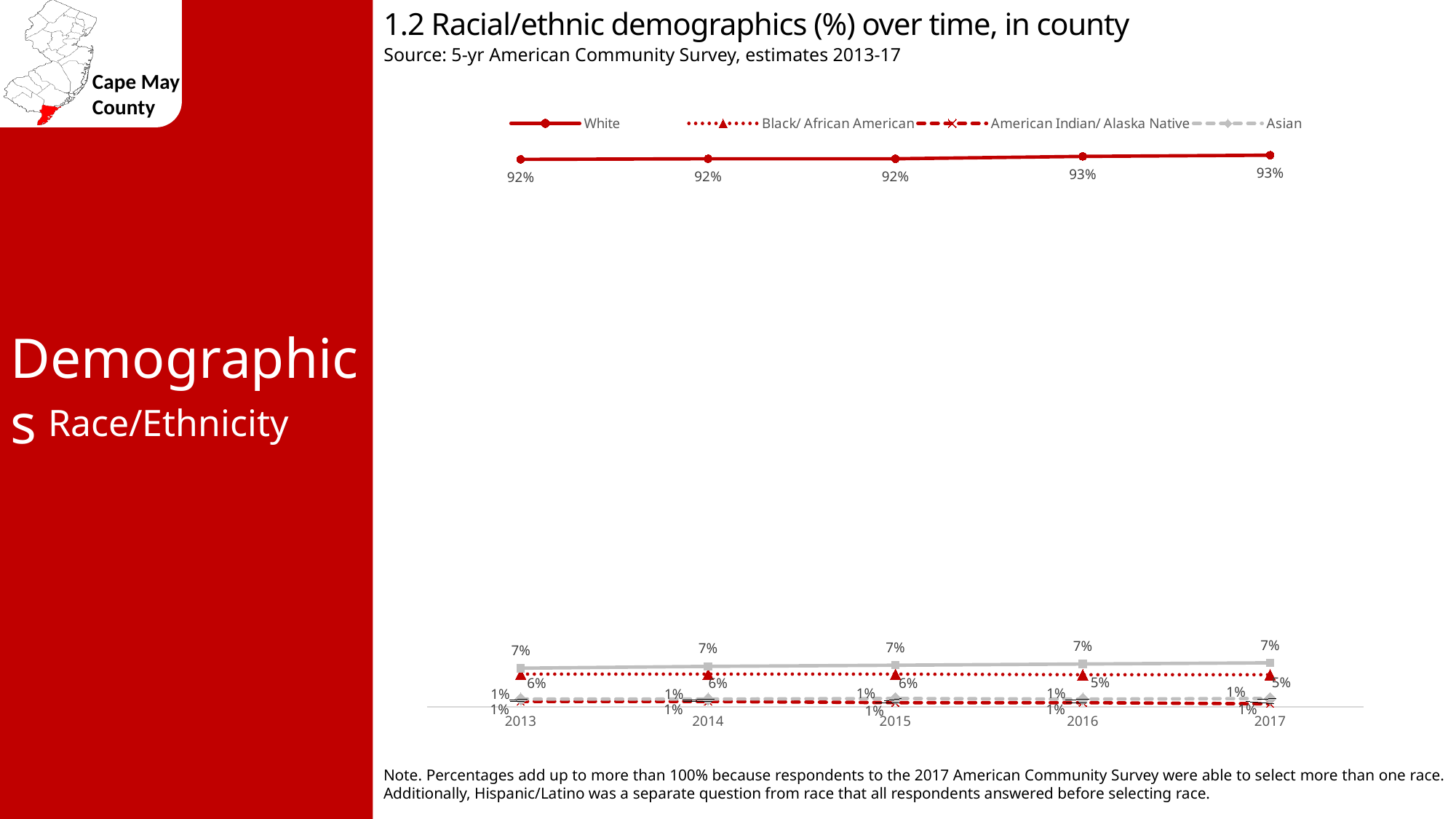
Which series has the highest values across all years? White What kind of chart is shown on the slide? Line chart What is the difference between the White value in 2017 and the White value in 2013? 1% How many years are shown on the x axis? 5 How many series does the legend list? 4 What is the value for Black/ African American in 2017? 5% What is the value for White in 2016? 93% What is the value for Black/ African American in 2013? 6% Which is larger in 2015: the value for White or the value for Black/ African American? White What is the value for White in 2013? 92% What is the value for White in 2017? 93% Does the White series rise or fall from 2013 to 2017? Rise